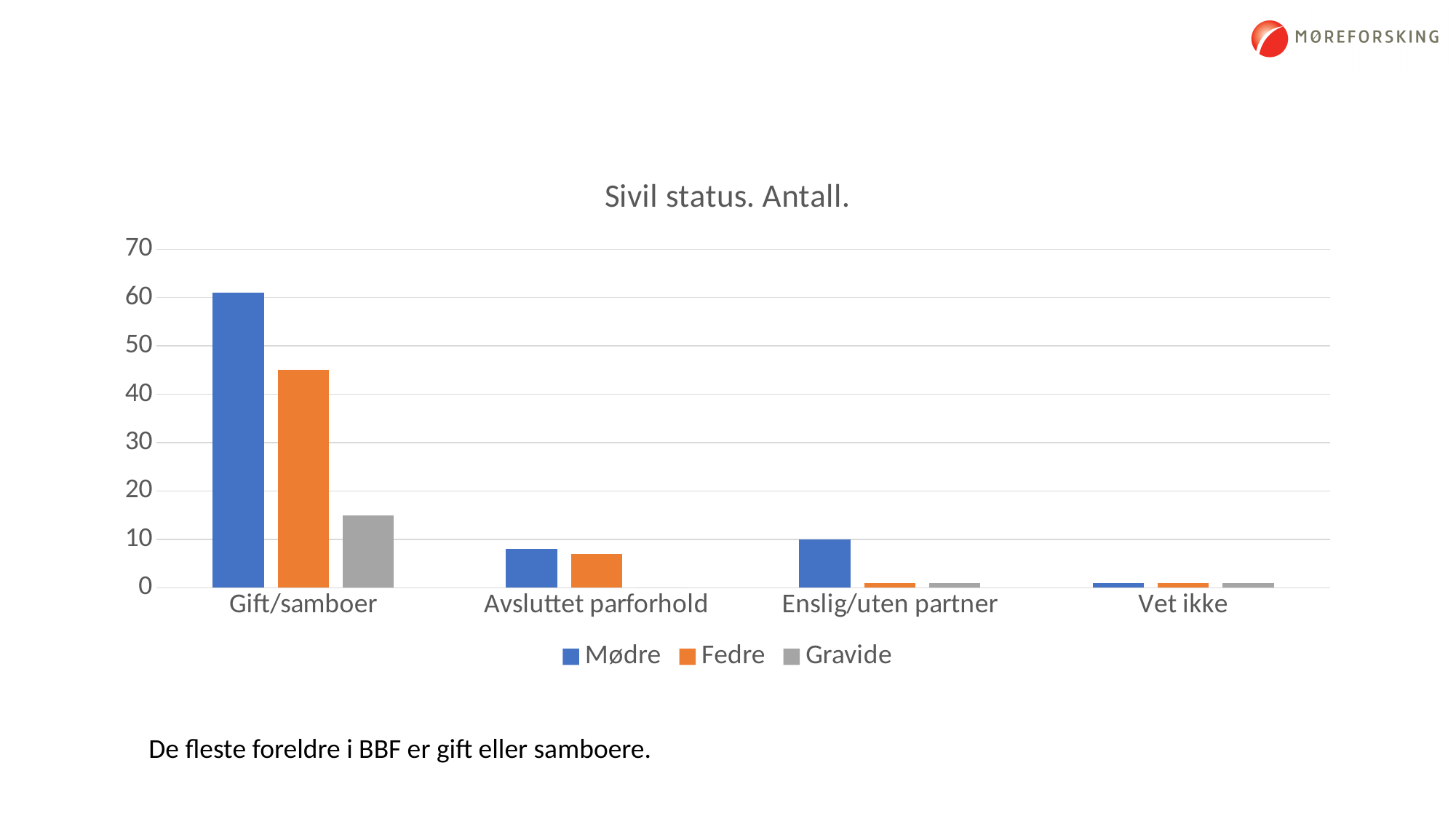
Which series is shown in grey in the legend? Gravide What is the title of the chart? Sivil status. Antall. Is the value for Mødre in Gift/samboer greater or less than 50? greater Which category has the highest value for Fedre? Gift/samboer What kind of chart is shown on the slide? bar chart How many series does the legend list? 3 How many categories are shown on the x axis? 4 Is the value for Gravide in Gift/samboer greater or less than 20? less Which is larger in Enslig/uten partner, Mødre or Fedre? Mødre Which is larger in Gift/samboer, Mødre or Fedre? Mødre Which category has the highest value for Mødre? Gift/samboer Is the value for Fedre in Gift/samboer greater or less than 40? greater